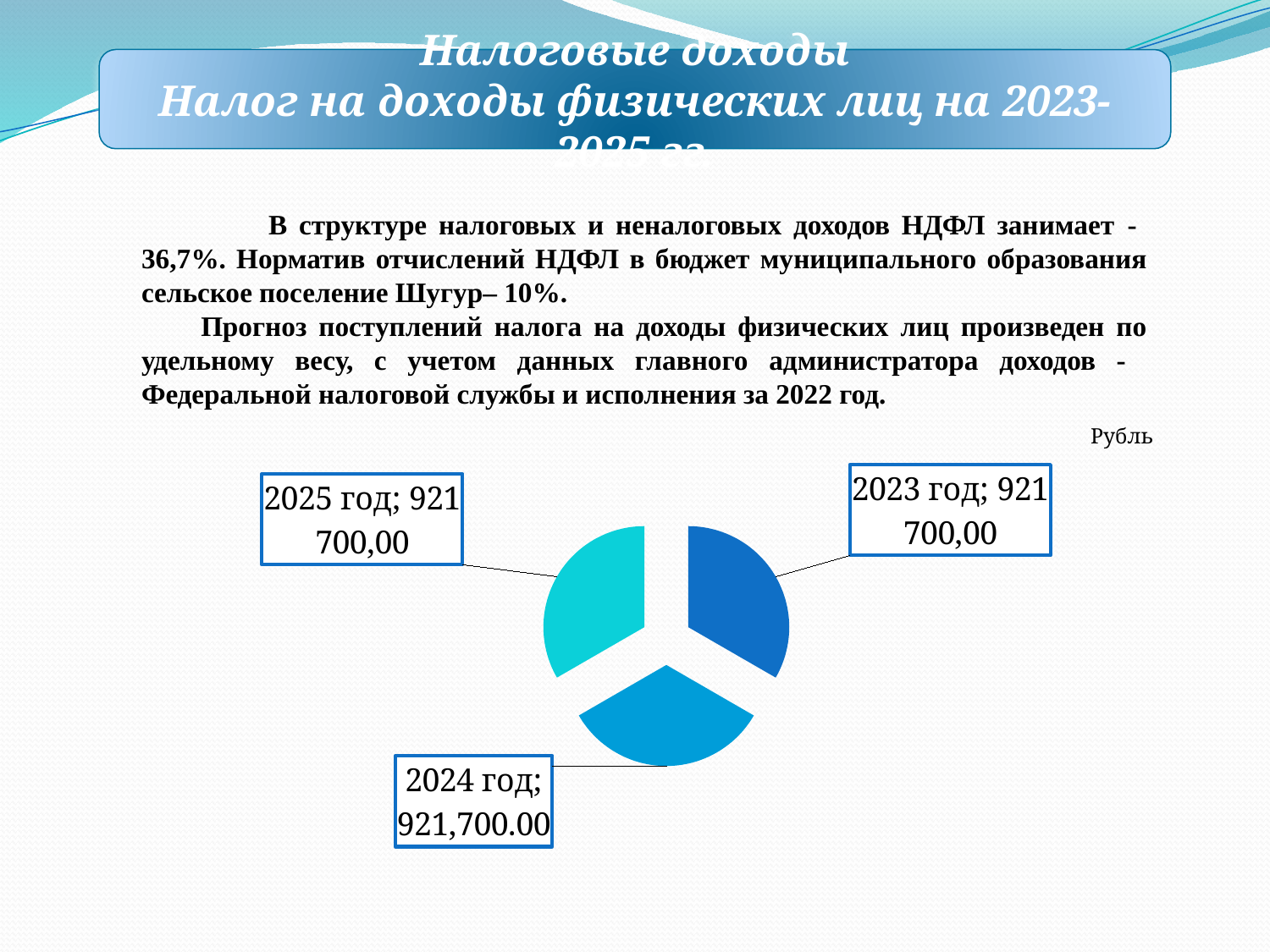
Which years are shown as slices of the pie chart? 2023 год, 2024 год, 2025 год What is the value shown for 2023 год on the pie chart? 921 700,00 What kind of chart is shown on the slide? Pie chart What is the value shown for 2025 год on the pie chart? 921 700,00 Do the values change from 2023 год to 2025 год? No, they stay the same What is the difference between the values for 2023 год and 2025 год? 0 Is the value for 2023 год larger than, smaller than, or equal to the value for 2025 год? Equal What unit is indicated above the pie chart? Рубль How many slices does the pie chart have? 3 What is the value shown for 2024 год on the pie chart? 921,700.00